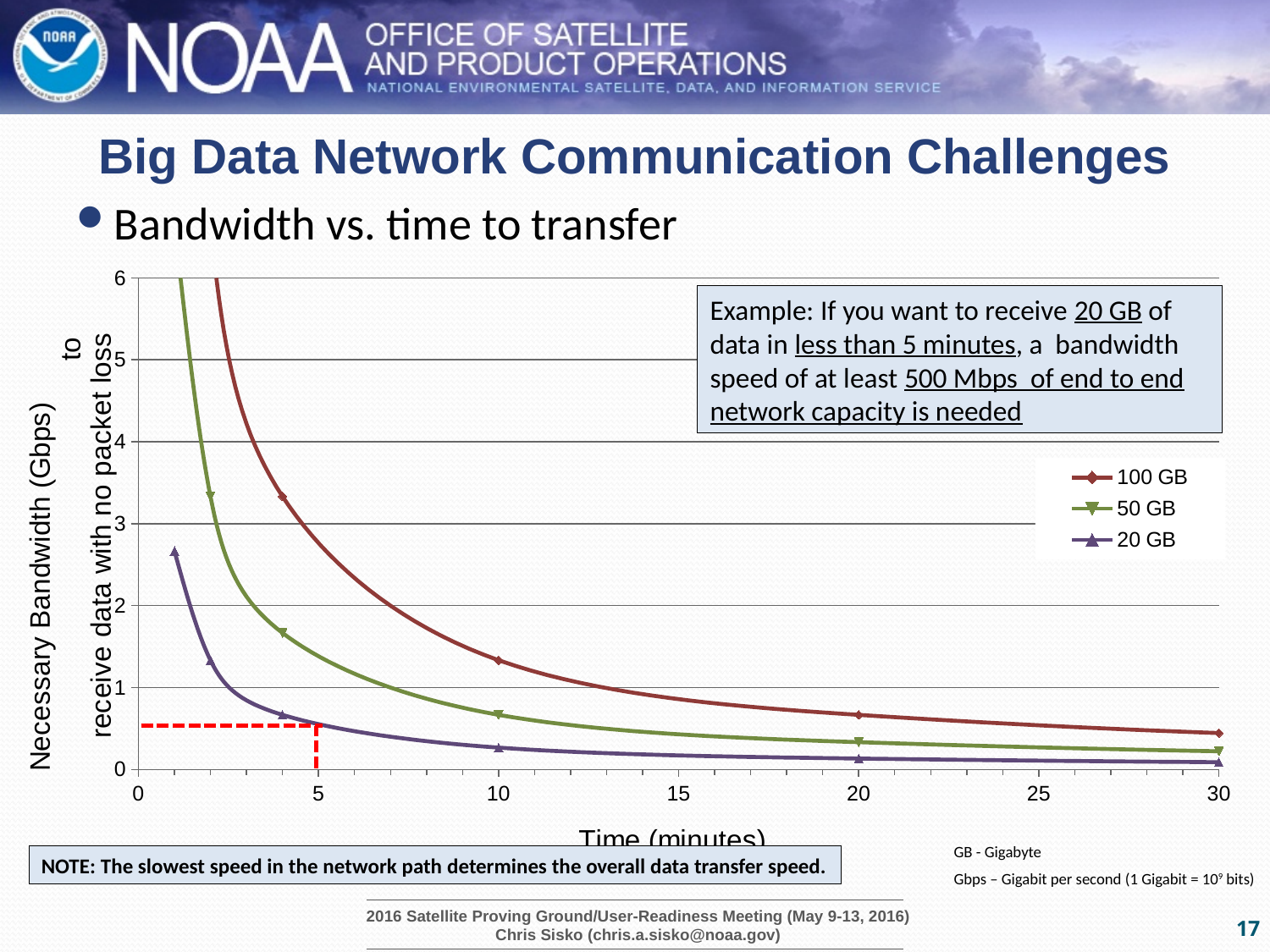
Is the necessary bandwidth for the 100 GB series at 10 minutes greater or less than 1 Gbps? greater Which series has the highest necessary bandwidth across the chart? 100 GB At 20 minutes, which series requires more bandwidth, 100 GB or 20 GB? 100 GB Is the necessary bandwidth for the 100 GB series at 30 minutes greater or less than 1 Gbps? less What is the title of the chart's x axis? Time (minutes) Is the necessary bandwidth for the 20 GB series at 10 minutes greater or less than 1 Gbps? less What are the three series listed in the chart's legend? 100 GB, 50 GB, 20 GB Do the necessary bandwidth values rise or fall as time increases along the x axis? fall What kind of chart is shown on the slide? line chart How many series does the chart's legend list? 3